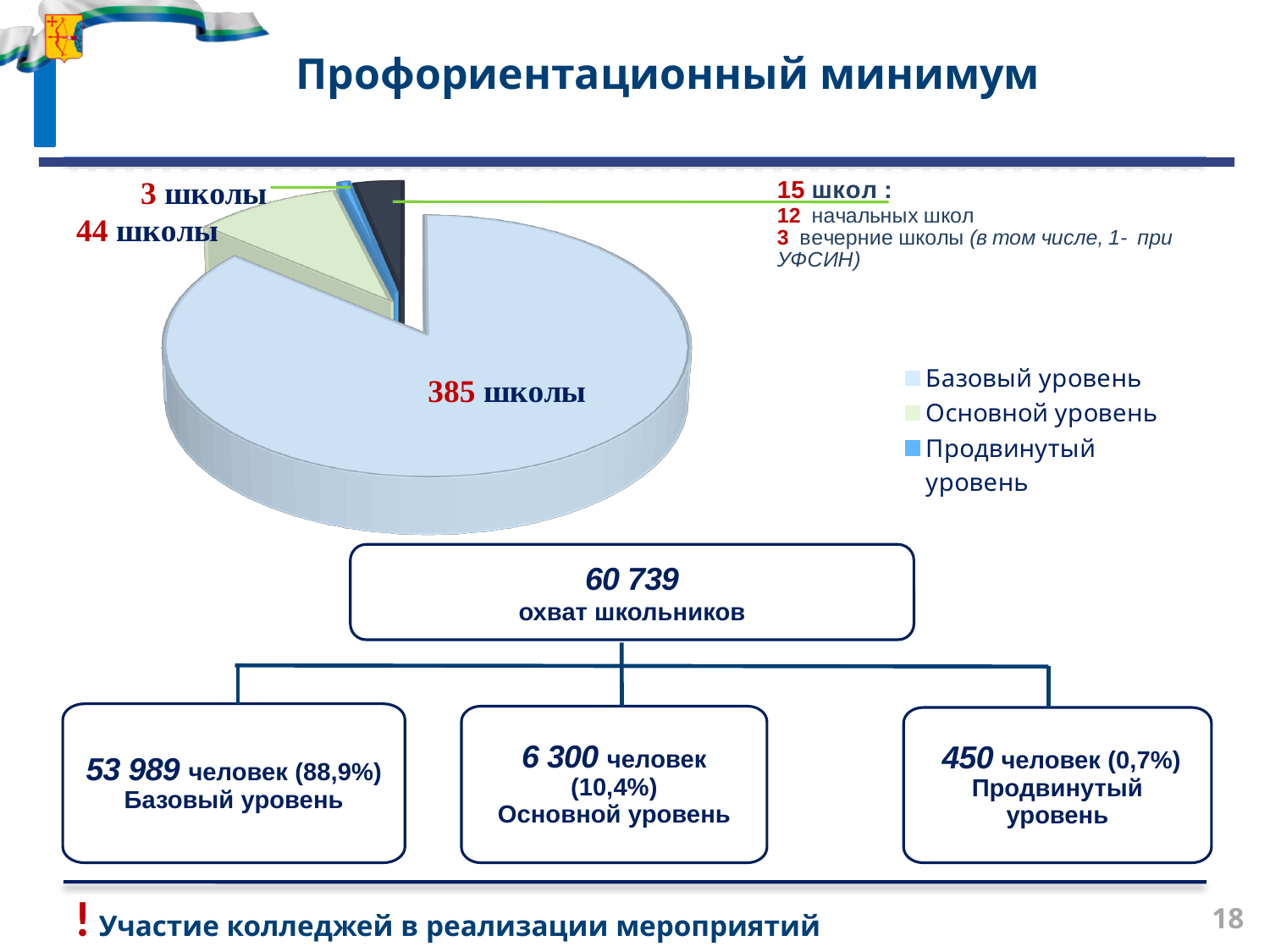
How many schools are in the Продвинутый уровень slice of the pie chart? 3 школы Which level has the smallest slice in the pie chart? Продвинутый уровень How many slices does the pie chart have? 4 What is the difference in the number of schools between the Основной уровень and Продвинутый уровень slices? 41 What is the difference in the number of schools between the Базовый уровень and Основной уровень slices? 341 Which slice is larger: Основной уровень or Продвинутый уровень? Основной уровень How many schools are in the Базовый уровень slice of the pie chart? 385 школы Which level has the largest slice in the pie chart? Базовый уровень How many entries does the legend of the pie chart list? 3 What kind of chart is shown on the slide? pie chart How many schools does the dark slice of the pie chart represent? 15 школ How many schools are in the Основной уровень slice of the pie chart? 44 школы